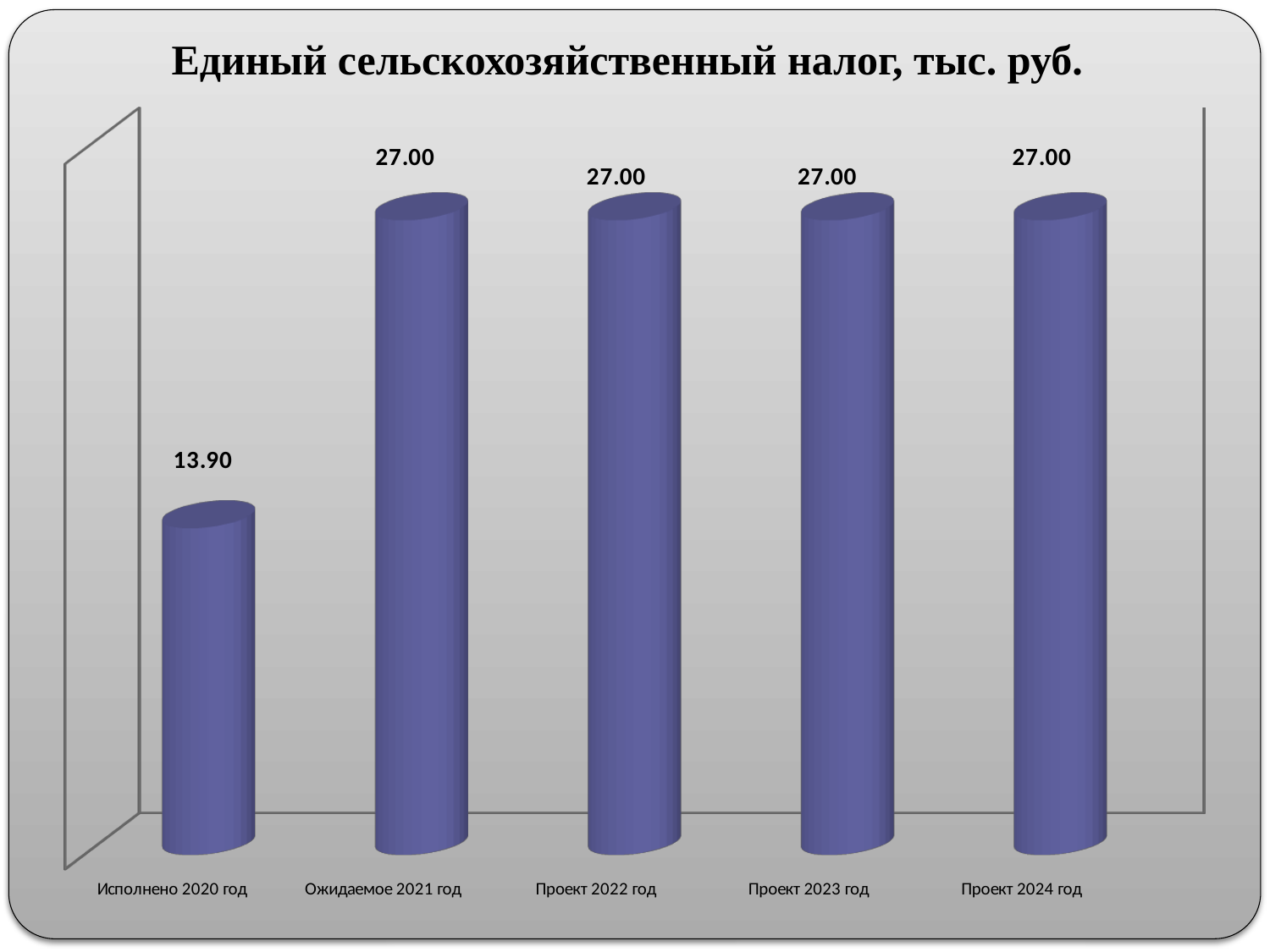
Which category has the lowest value? Исполнено 2020 год What is the difference between the values for Ожидаемое 2021 год and Исполнено 2020 год? 13.10 What is the value for Проект 2024 год? 27.00 How many categories have a value of 27.00? 4 What is the value for Ожидаемое 2021 год? 27.00 What kind of chart is shown on the slide? bar chart What is the title of the chart? Единый сельскохозяйственный налог, тыс. руб. Which is larger, the value for Проект 2022 год or the value for Исполнено 2020 год? Проект 2022 год How many categories are shown on the chart? 5 What is the value for Исполнено 2020 год? 13.90 Do the values rise or fall from Исполнено 2020 год to Ожидаемое 2021 год? rise What is the value for Проект 2023 год? 27.00